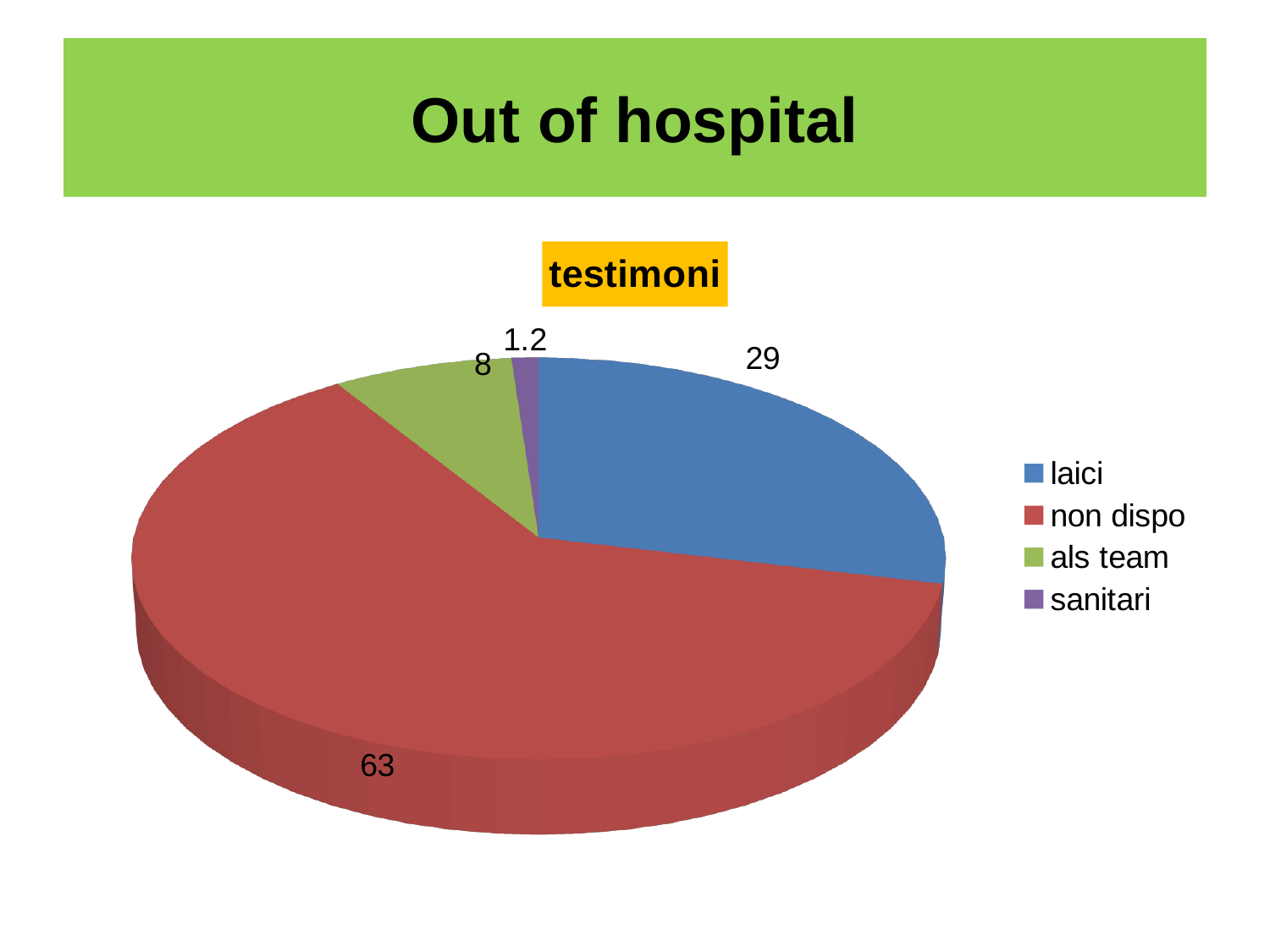
What is the title of the chart? testimoni Which category has the smallest slice? sanitari What is the value for non dispo? 63 Which is larger, the value for laici or the value for als team? laici What is the value for laici? 29 What is the value for als team? 8 What is the value for sanitari? 1.2 Which category has the largest slice? non dispo What type of chart is shown on the slide? pie chart Which colour represents non dispo in the legend? red What is the difference between the values for non dispo and laici? 34 How many categories does the pie chart have? 4